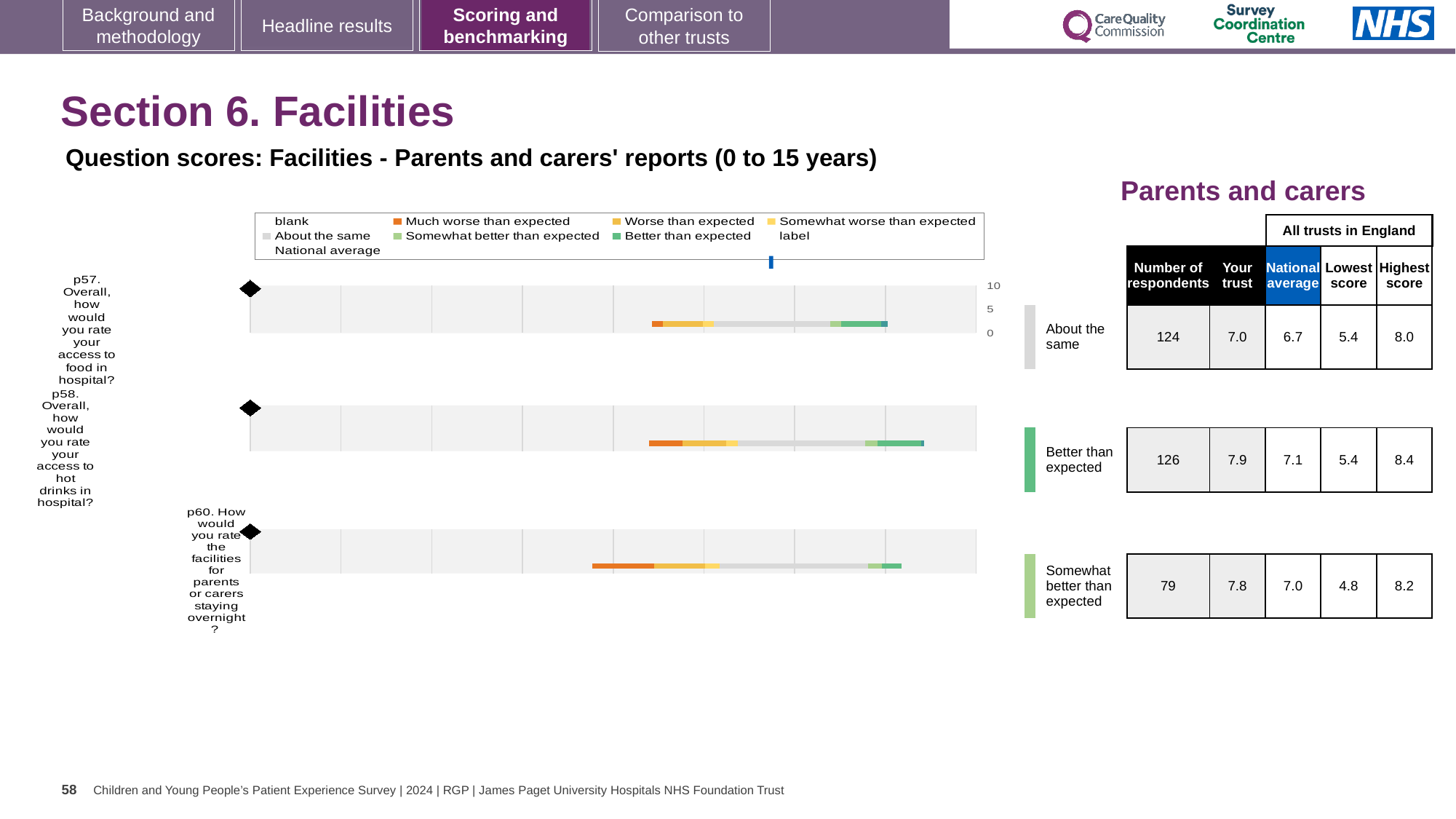
For p57, which is larger: the 'Your trust' score or the national average? Your trust According to the table beside the chart, what is the national average for p58 (access to hot drinks in hospital)? 7.1 Which question has the fewest respondents? p60 (facilities for parents or carers staying overnight) What is the highest score across all trusts in England for p58? 8.4 Which benchmark category is shown for p58 (access to hot drinks in hospital)? Better than expected What type of chart is used to show the question scores on this slide? bar chart According to the table beside the chart, what is the 'Your trust' score for p57 (access to food in hospital)? 7.0 Which question has the highest 'Your trust' score? p58 (access to hot drinks in hospital) How many respondents answered p60 (facilities for parents or carers staying overnight)? 79 How many questions (categories) are plotted in the chart? 3 What is the lowest score across all trusts in England for p60? 4.8 What is the difference between the 'Your trust' score and the national average for p58? 0.8